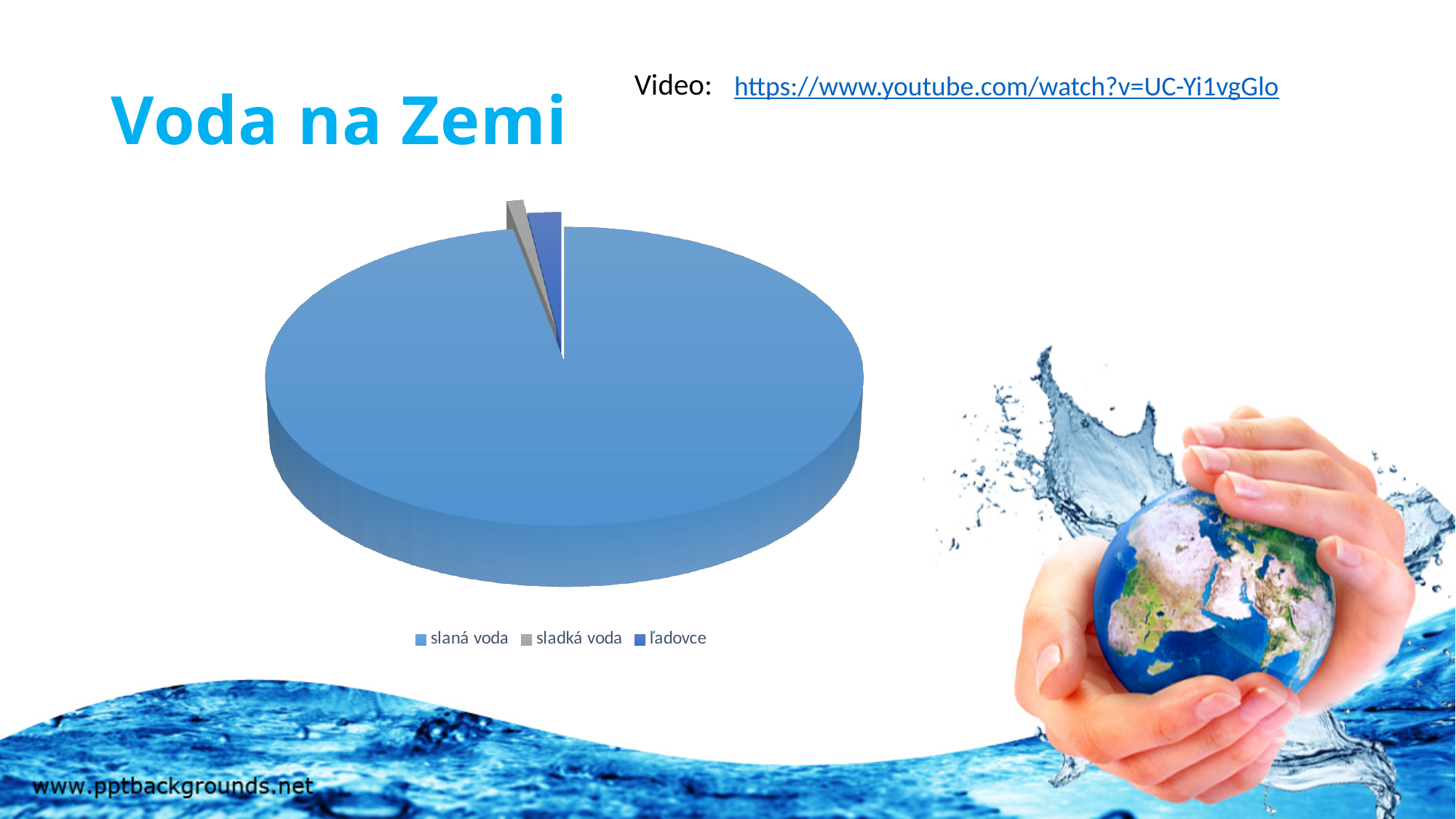
Which category has the largest slice in the pie chart? slaná voda Which slice is larger, slaná voda or ľadovce? slaná voda How many entries does the legend of the pie chart list? 3 What is the title of the slide containing the pie chart? Voda na Zemi How many slices does the pie chart have? 3 Which slice is larger, slaná voda or sladká voda? slaná voda What kind of chart is shown on the slide? pie chart What colour is the slaná voda slice in the pie chart? light blue What colour is the sladká voda slice in the pie chart? gray